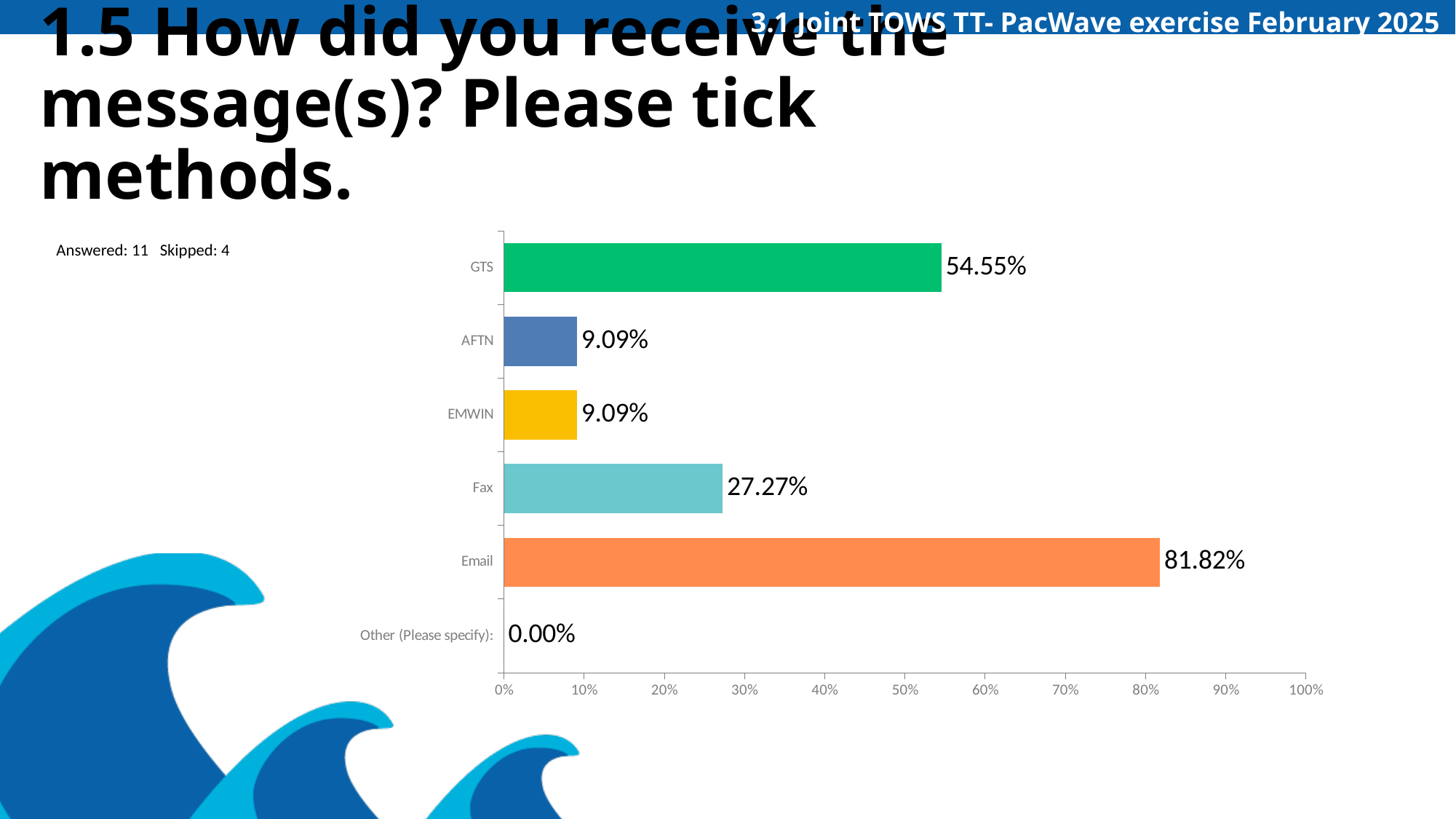
What is the value for Other (Please specify)? 0.00% Which category has the highest value? Email Which is larger, the value for GTS or the value for Fax? GTS What is the value for AFTN? 9.09% What is the value for Email? 81.82% How many categories are shown in the chart? 6 Is the value for Fax greater or less than 30%? less What is the value for GTS? 54.55% What is the value for Fax? 27.27% What is the difference between the values for Email and GTS? 27.27% Which category has the lowest value? Other (Please specify) What kind of chart is shown on the slide? bar chart